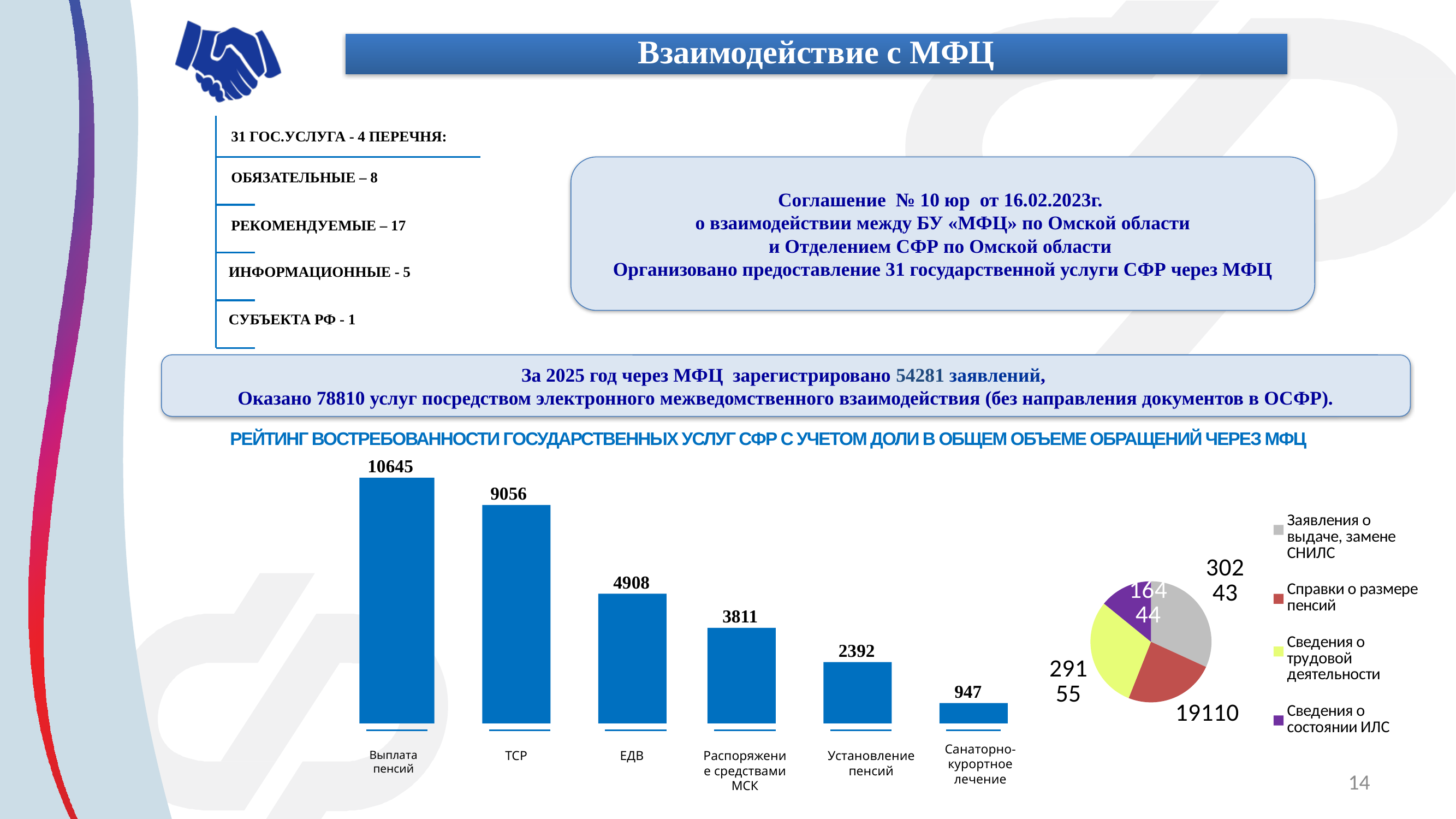
In the pie chart, which slice has the largest value? Заявления о выдаче, замене СНИЛС In the bar chart, which category has the highest value? Выплата пенсий In the bar chart, what is the difference between the values for ЕДВ and Установление пенсий? 2516 In the bar chart, what is the value for Санаторно-курортное лечение? 947 Do the values in the bar chart rise or fall from left to right? fall How many entries does the pie chart legend list? 4 In the bar chart, what is the value for Выплата пенсий? 10645 How many categories does the bar chart show? 6 In the bar chart, which is larger: Распоряжение средствами МСК or Установление пенсий? Распоряжение средствами МСК In the bar chart, what is the value for ТСР? 9056 In the bar chart, which category has the lowest value? Санаторно-курортное лечение In the pie chart, what is the value for Справки о размере пенсий? 19110